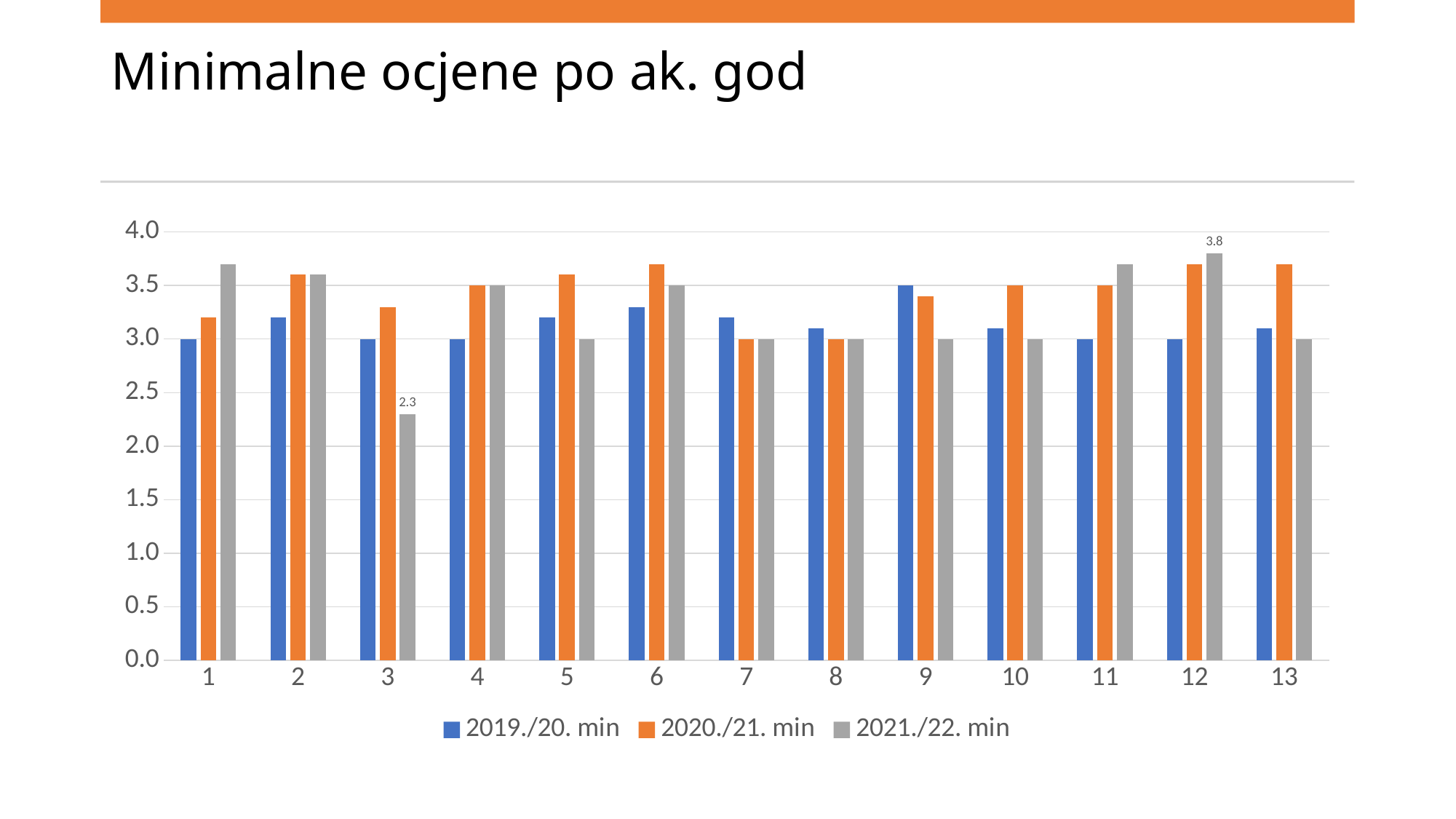
What is the title of the chart on the slide? Minimalne ocjene po ak. god How many series does the legend list? 3 For category 3, which is larger: the 2020./21. min or the 2021./22. min? 2020./21. min Is the 2020./21. min value for category 6 greater or less than 3.5? greater For category 9, which is larger: the 2019./20. min or the 2021./22. min? 2019./20. min Is the 2019./20. min value for category 2 greater or less than 3.5? less What kind of chart is shown on the slide? Bar chart Which category has the lowest 2021./22. min value? 3 What is the difference between the 2021./22. min values for category 12 and category 3? 1.5 How many categories are shown along the x axis? 13 What is the 2021./22. min value for category 12? 3.8 What is the 2021./22. min value for category 3? 2.3